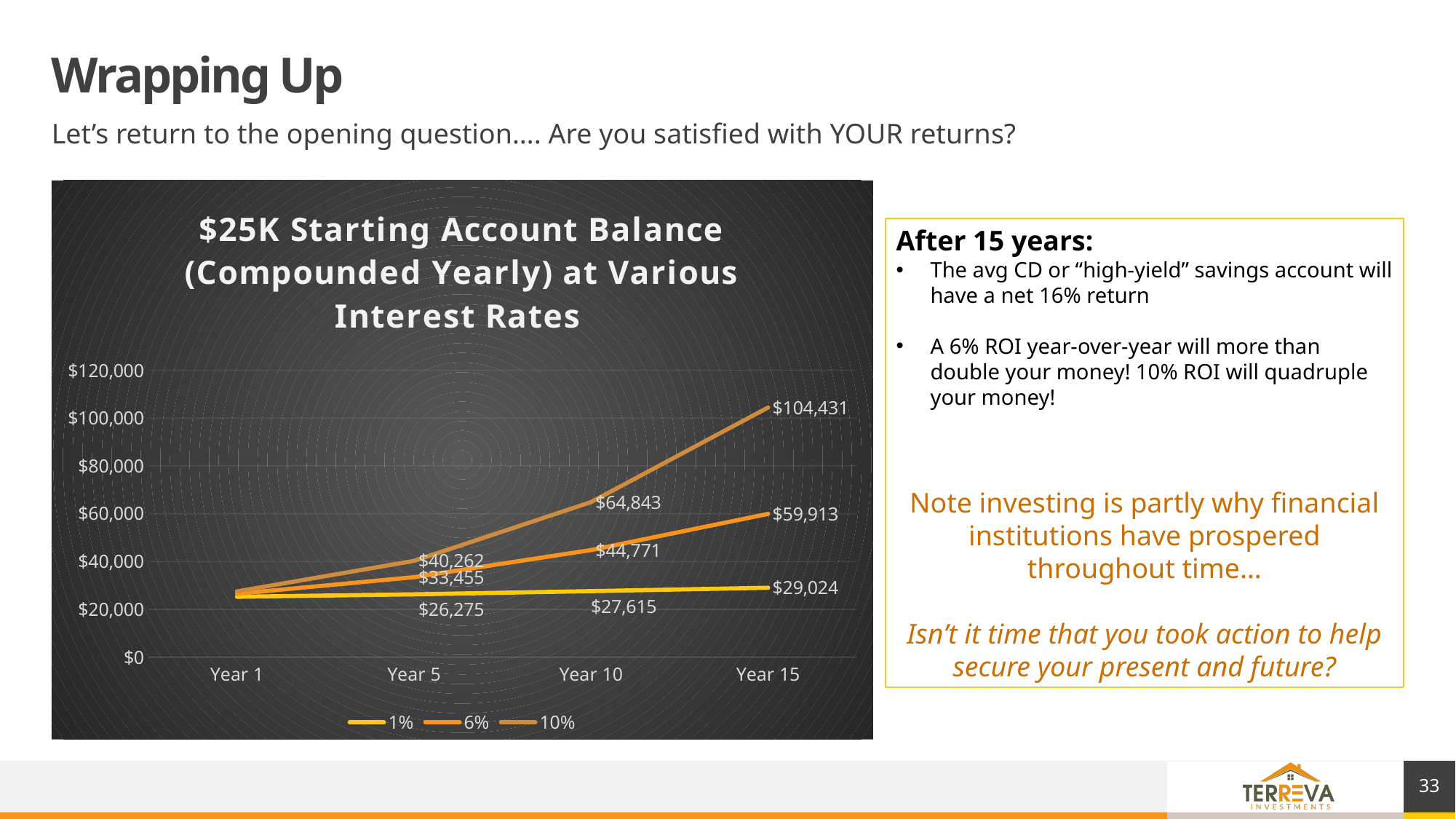
What is the account balance for the 6% series at Year 10? $44,771 What is the difference between the 10% and 6% balances at Year 15? $44,518 What kind of chart is shown on the slide? Line chart How many points are on the x axis of the chart? 4 Which series has the highest balance at Year 15? 10% Do the values for the 10% series rise or fall from Year 1 to Year 15? Rise What is the account balance for the 10% series at Year 15? $104,431 What is the title of the chart? $25K Starting Account Balance (Compounded Yearly) at Various Interest Rates How many series does the legend list? 3 Which series has the lowest balance at Year 10? 1% Which is larger at Year 5: the 6% balance or the 1% balance? 6% What is the account balance for the 1% series at Year 5? $26,275